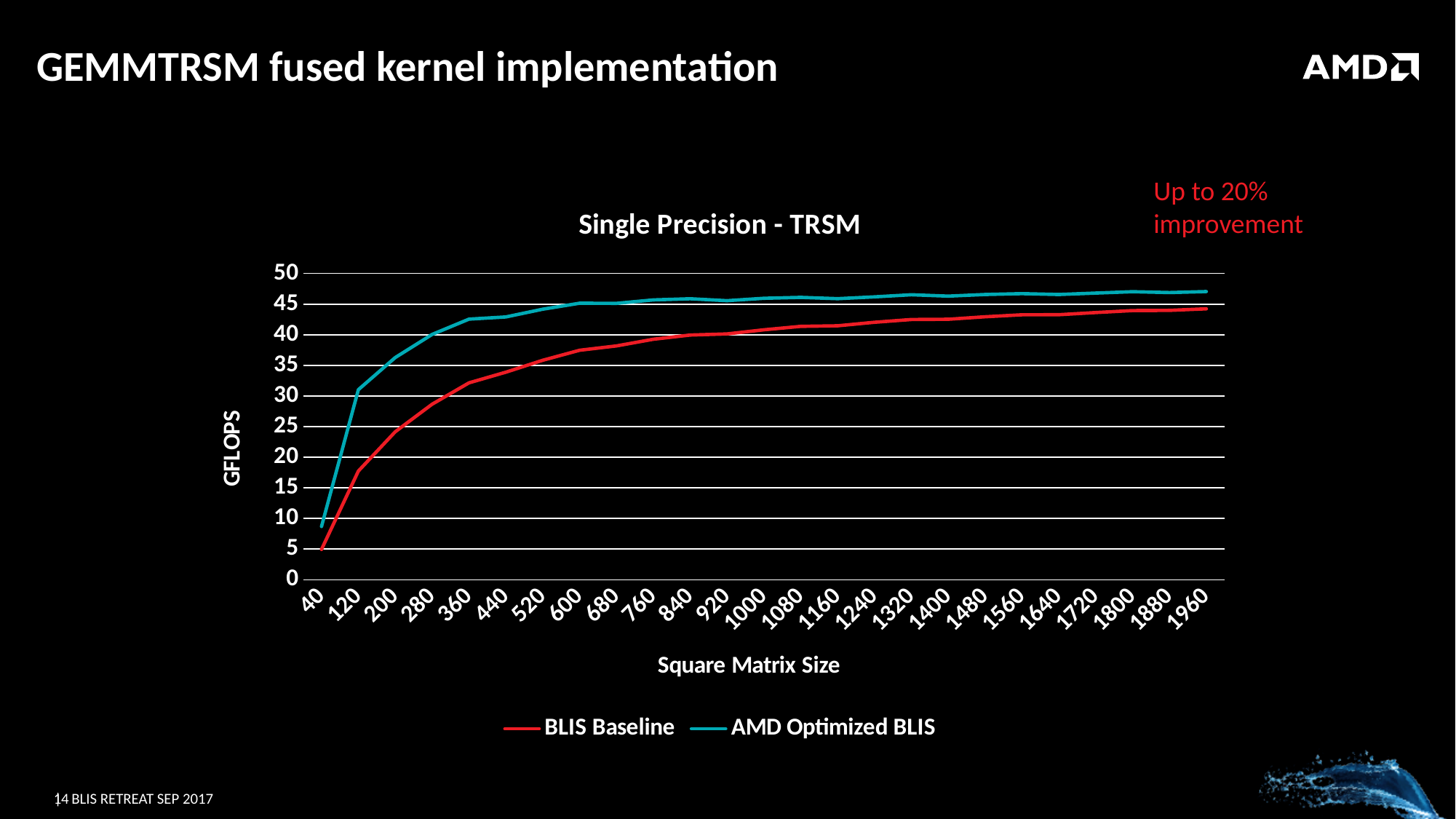
Is the value for BLIS Baseline at matrix size 120 greater or less than 20? less How many matrix sizes are labelled on the x axis? 25 What is the label of the y axis? GFLOPS Is the value for AMD Optimized BLIS at matrix size 360 greater or less than 40? greater What is the title of the chart? Single Precision - TRSM Which series has the higher value at matrix size 600, BLIS Baseline or AMD Optimized BLIS? AMD Optimized BLIS Is the value for BLIS Baseline at matrix size 1960 greater or less than 40? greater What kind of chart is shown on the slide? line chart Do the GFLOPS values for BLIS Baseline rise or fall as the square matrix size increases? rise How many series does the legend list? 2